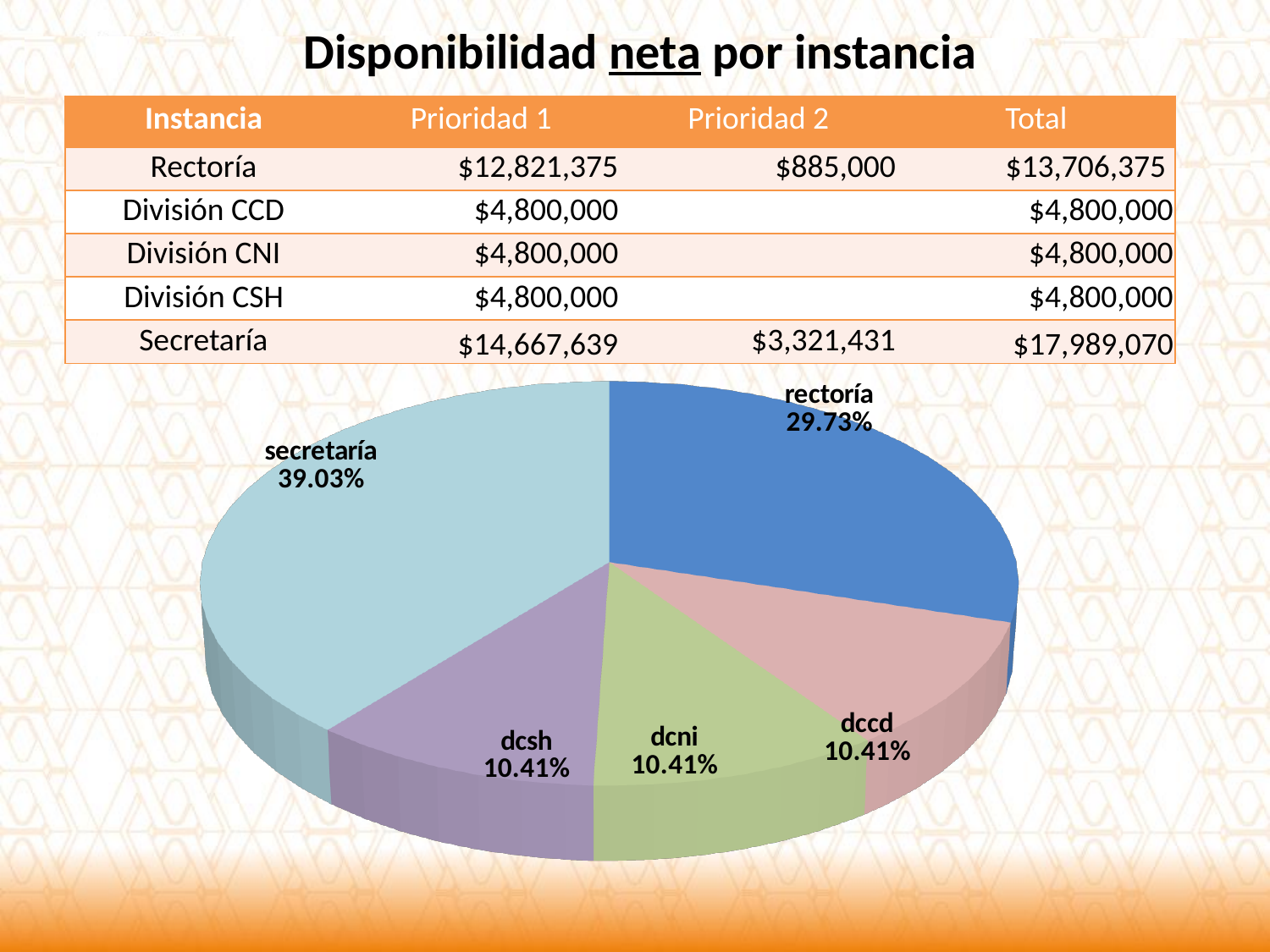
Which slice is larger, rectoría or dcni? rectoría What share of the pie does rectoría represent? 29.73% What share of the pie does secretaría represent? 39.03% What kind of chart is shown on the slide? pie chart What share of the pie does dcsh represent? 10.41% How many slices does the pie chart have? 5 How many slices in the pie chart share the same value of 10.41%? 3 What is the difference in percentage points between the rectoría slice and the dccd slice? 19.32 Which slice of the pie chart is the largest? secretaría What is the title of the slide containing the pie chart? Disponibilidad neta por instancia What is the difference in percentage points between the secretaría slice and the rectoría slice? 9.30